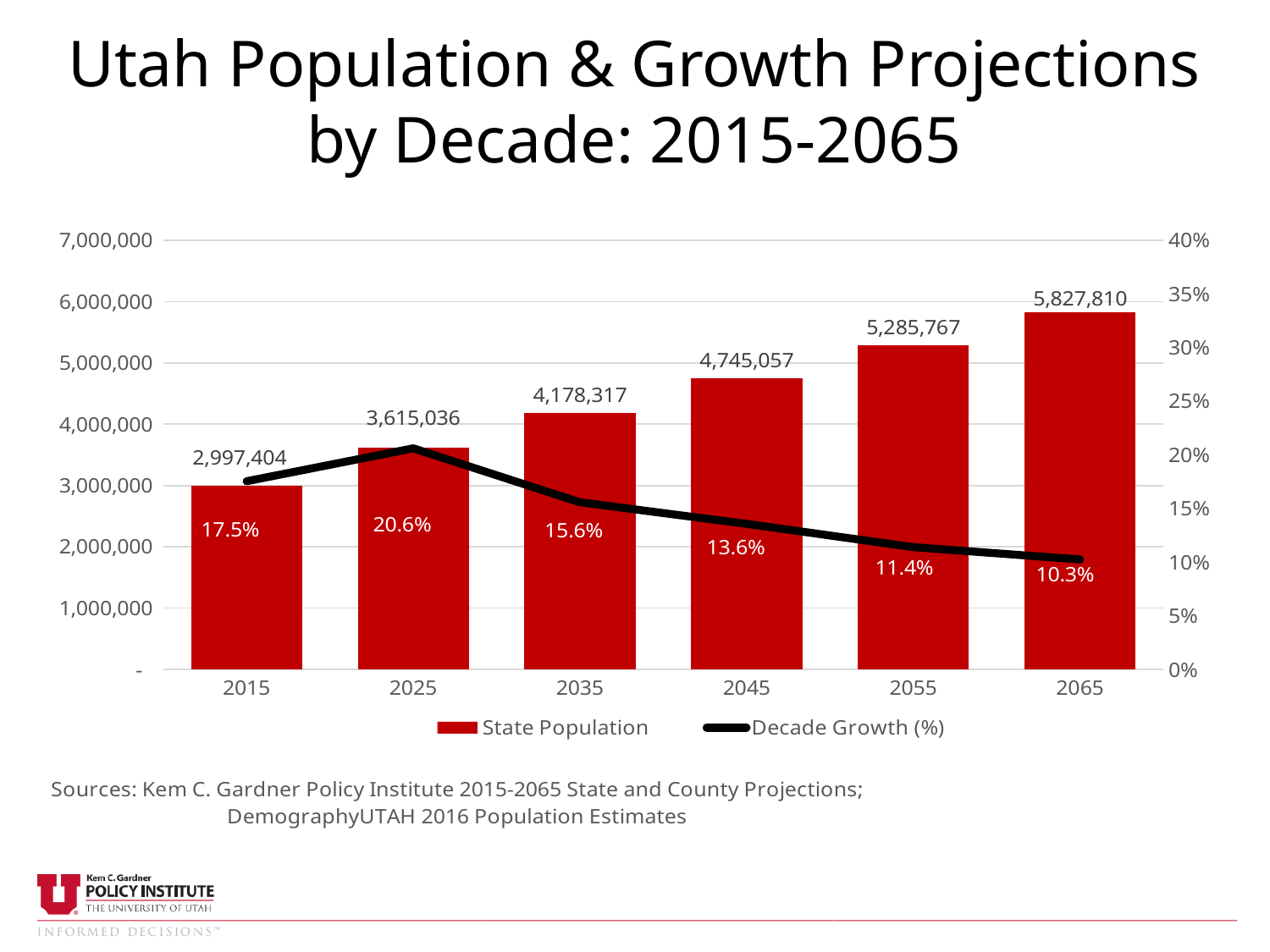
What is the projected State Population for 2045? 4,745,057 How many series does the legend list? 2 What is the Decade Growth (%) value for 2025? 20.6% What is the difference in Decade Growth (%) between 2015 and 2035? 1.9% Which year has the highest State Population? 2065 What is the State Population value for 2015? 2,997,404 How many decades (years) are shown on the x axis? 6 What is the difference in State Population between 2065 and 2055? 542,043 Which is larger, the State Population in 2035 or in 2025? 2035 Does the Decade Growth (%) rise or fall from 2025 to 2065? fall Which year has the lowest Decade Growth (%)? 2065 Which year has the highest Decade Growth (%)? 2025